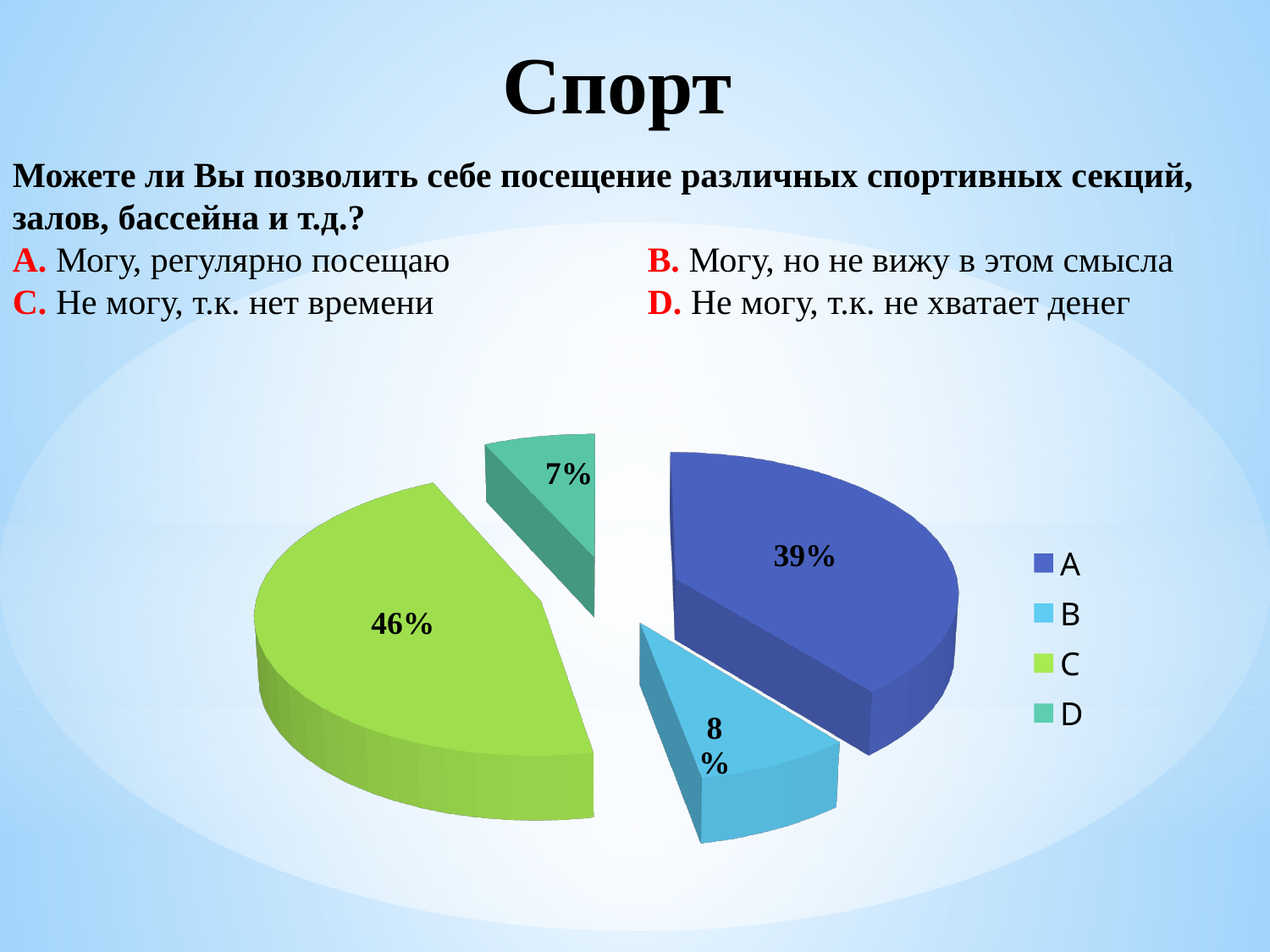
Which is larger, the share for A or the share for B? A What kind of chart is shown on the slide? Pie chart How many slices does the pie chart have? 4 Which category has the smallest share of the pie? D How many entries does the legend list? 4 What percentage of the pie does slice A represent? 39% What is the difference in percentage points between slice C and slice A? 7 What percentage of the pie does slice C represent? 46% What is the title of the slide containing the chart? Спорт What percentage of the pie does slice B represent? 8% Which category has the largest share of the pie? C What percentage of the pie does slice D represent? 7%